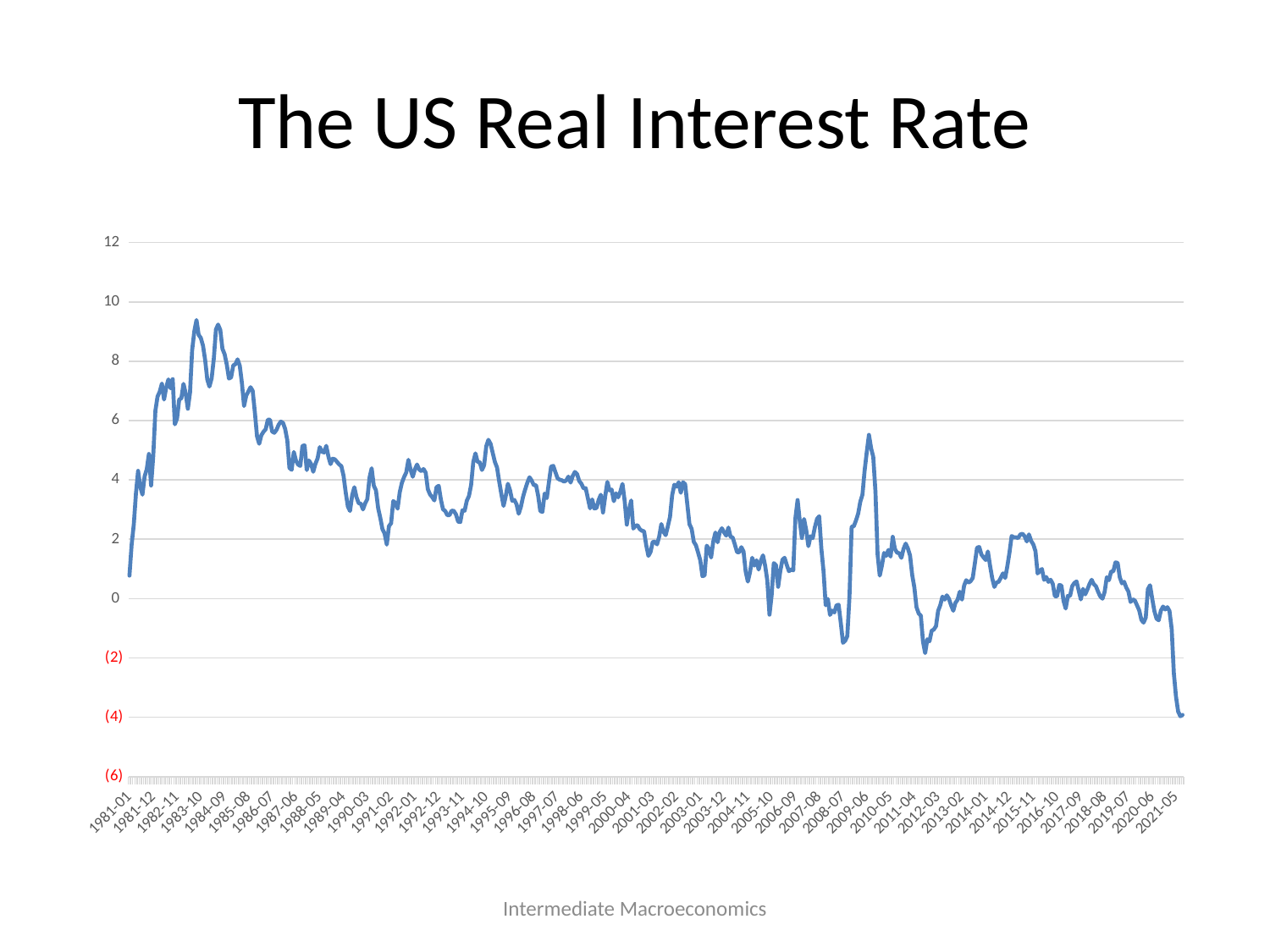
Is the value at 2012-03 greater or less than 0? less Is the highest value reached by the line greater or less than 8? greater Over the whole period from 1981-01 to 2021-05, does the real interest rate generally rise or fall? fall What is the highest value shown on the vertical axis? 12 Is the value at 2009-06 greater or less than 4? greater Which is larger, the value at 1990-03 or the value at 2021-05? 1990-03 What is the title of the chart? The US Real Interest Rate What kind of chart is shown on the slide? line chart Which is larger, the value at 1984-09 or the value at 1981-01? 1984-09